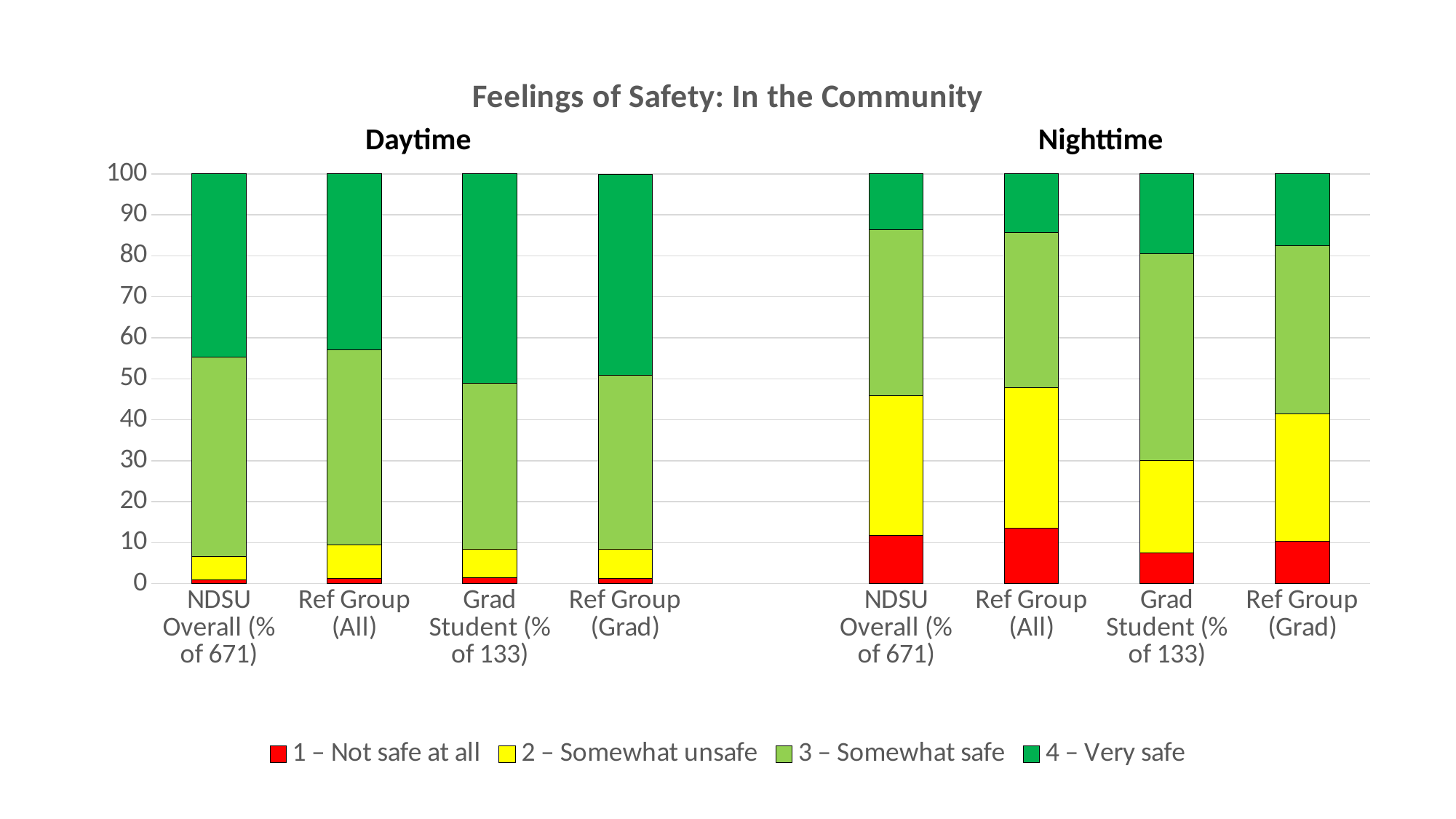
Is the top of the '3 – Somewhat safe' segment for Daytime Ref Group (All) greater or less than 50? greater Which legend entry is shown in red? 1 – Not safe at all Which has the larger '1 – Not safe at all' segment: Nighttime Grad Student or Nighttime Ref Group (All)? Nighttime Ref Group (All) What total does each stacked bar reach on the vertical axis? 100 Which has the larger '4 – Very safe' segment: Daytime Grad Student or Nighttime Grad Student? Daytime Grad Student What kind of chart is shown on the slide? stacked bar chart Is the '1 – Not safe at all' segment for Nighttime NDSU Overall greater or less than 10? greater Is the top of the '2 – Somewhat unsafe' segment for Nighttime NDSU Overall greater or less than 40? greater What is the title of the chart? Feelings of Safety: In the Community How many stacked bars are plotted in total across the Daytime and Nighttime groups? 8 How many series does the legend list? 4